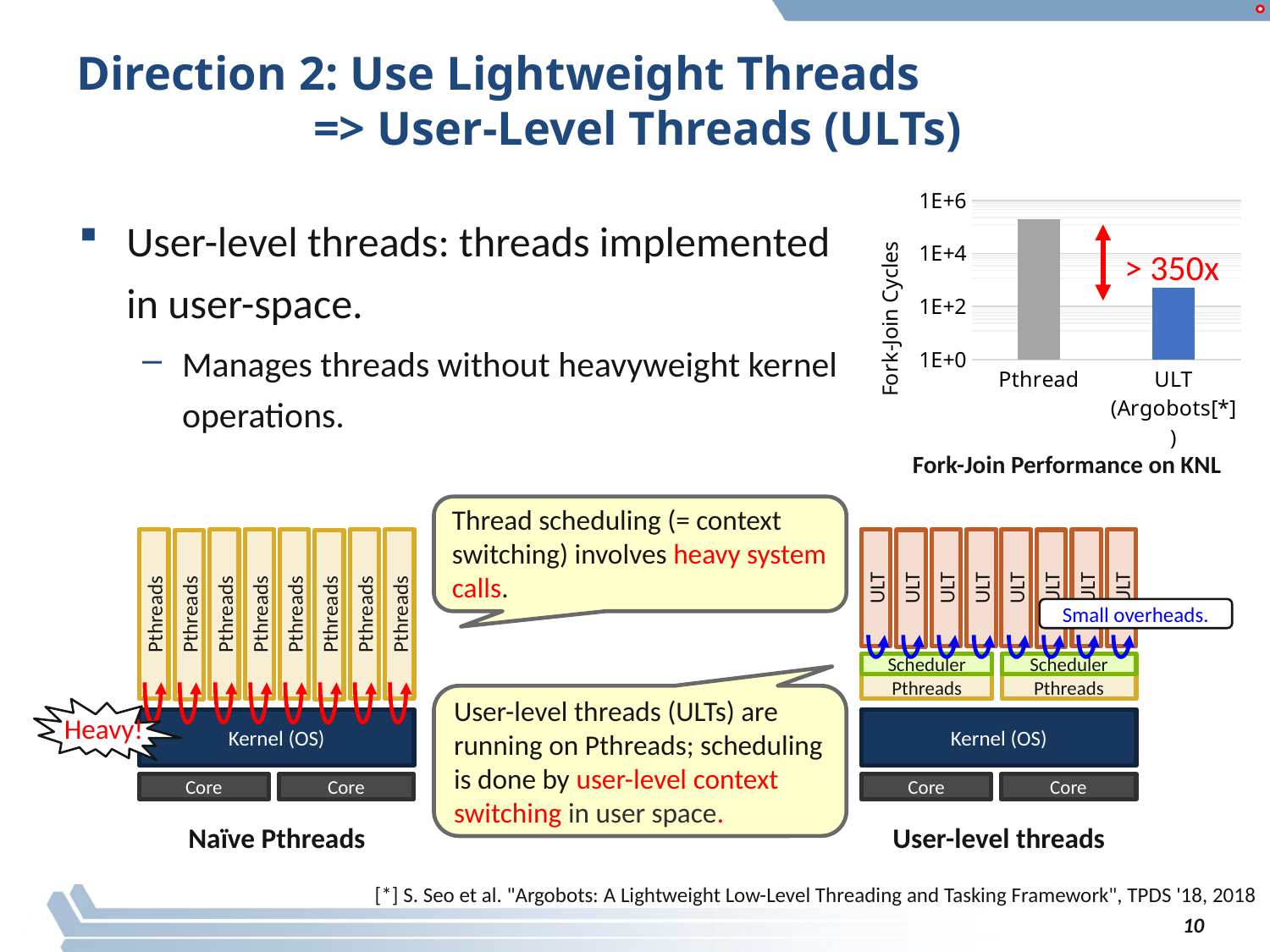
In the Fork-Join Performance on KNL chart, is the value for Pthread greater or less than 1E+6? less In the Fork-Join Performance on KNL chart, which has more fork-join cycles, Pthread or ULT? Pthread In the Fork-Join Performance on KNL chart, is the value for ULT greater or less than 1E+4? less In the Fork-Join Performance on KNL chart, is the value for Pthread greater or less than 1E+4? greater How many categories are plotted in the Fork-Join Performance on KNL chart? 2 What ratio annotation is shown between the two bars in the Fork-Join Performance on KNL chart? > 350x What is the y-axis label of the Fork-Join Performance on KNL chart? Fork-Join Cycles Which category has the lowest value in the Fork-Join Performance on KNL chart? ULT (Argobots[*]) What is the title of the chart on the slide? Fork-Join Performance on KNL What kind of chart is shown in the top right of the slide? bar chart Which category has the highest value in the Fork-Join Performance on KNL chart? Pthread